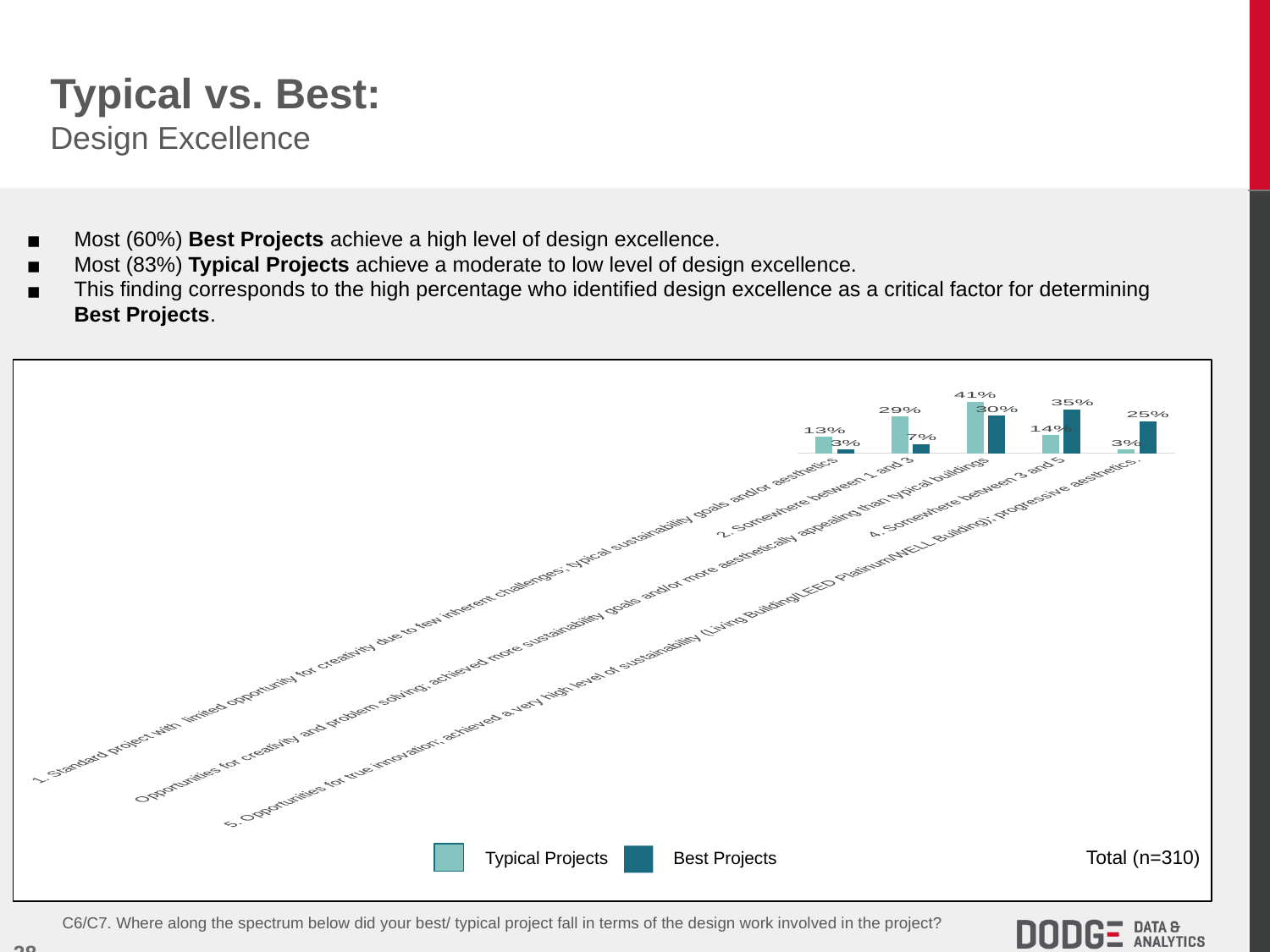
What is the difference between Best Projects and Typical Projects in category "4. Somewhere between 3 and 5"? 21% What is the value for Best Projects in category "4. Somewhere between 3 and 5"? 35% How many series does the chart legend list? 2 What kind of chart is shown on the slide? bar chart Which category has the lowest value for Best Projects? 1. Standard project with limited opportunity for creativity due to few inherent challenges; typical sustainability goals and/or aesthetics What is the value for Best Projects in category 1 (Standard project with limited opportunity for creativity)? 3% What is the value for Typical Projects in category "2. Somewhere between 1 and 3"? 29% What total sample size is noted on the chart? Total (n=310) Which category has the highest value for Typical Projects? Opportunities for creativity and problem solving; achieved more sustainability goals and/or more aesthetically appealing than typical buildings What is the difference between Typical Projects and Best Projects in category 3? 11% In category 5 (Opportunities for true innovation), which series has the larger value, Typical Projects or Best Projects? Best Projects How many categories are plotted along the x axis of the chart? 5